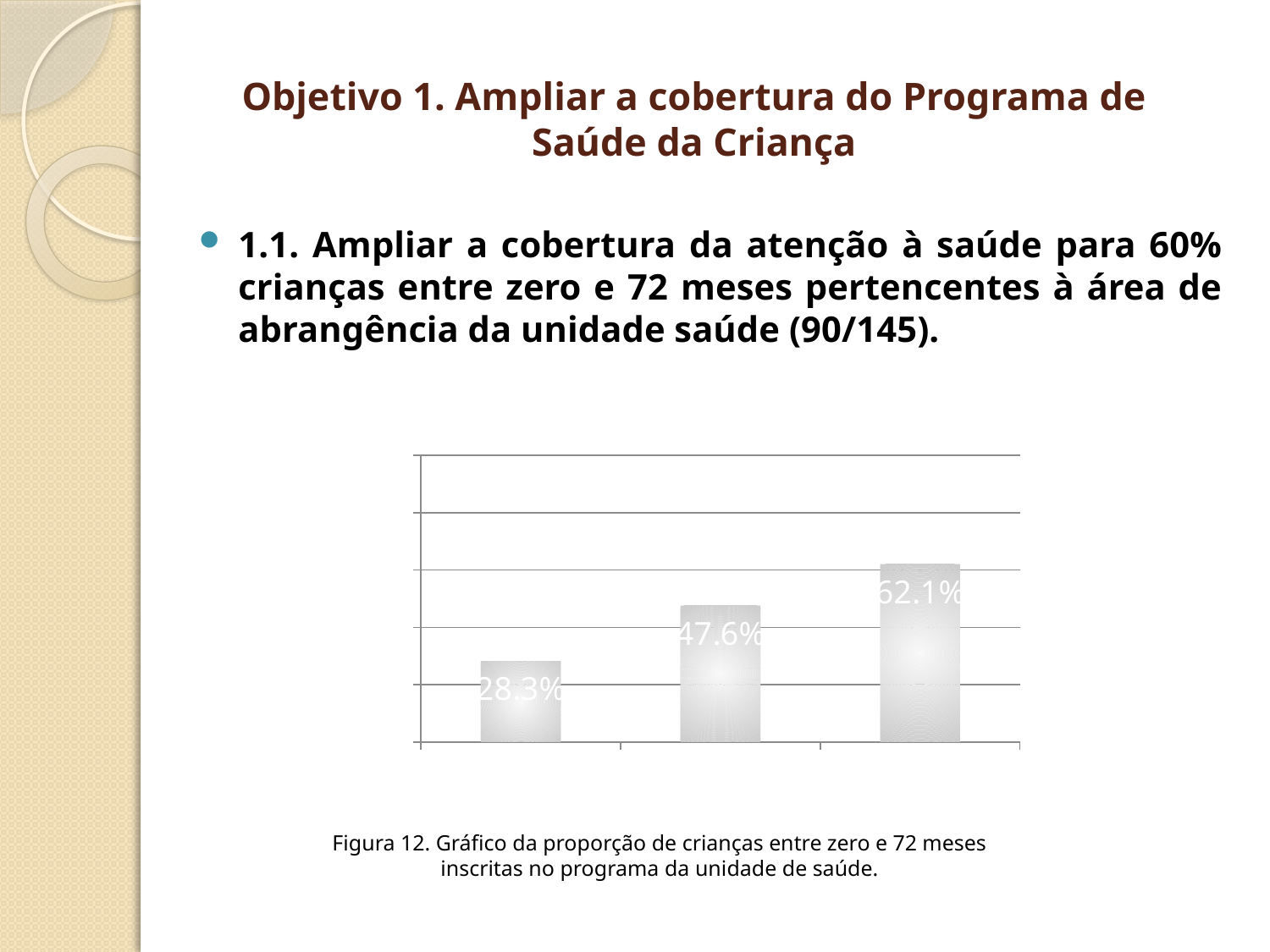
Which bar has the highest value in the chart? The third (rightmost) bar, 62.1% Do the bar values rise or fall from left to right across the chart? Rise How many bars are plotted in the chart? 3 What is the difference between the middle bar and the leftmost bar? 19.3% What value is shown on the first (leftmost) bar of the chart? 28.3% Which bar has the lowest value in the chart? The first (leftmost) bar, 28.3% What value is shown on the middle bar of the chart? 47.6% What is the difference between the value of the rightmost bar and the leftmost bar? 33.8% What value is shown on the third (rightmost) bar of the chart? 62.1% What type of chart is shown on the slide? Bar chart Which is larger, the value of the middle bar or the value of the leftmost bar? The middle bar (47.6%) What figure number is given in the caption below the chart? Figura 12